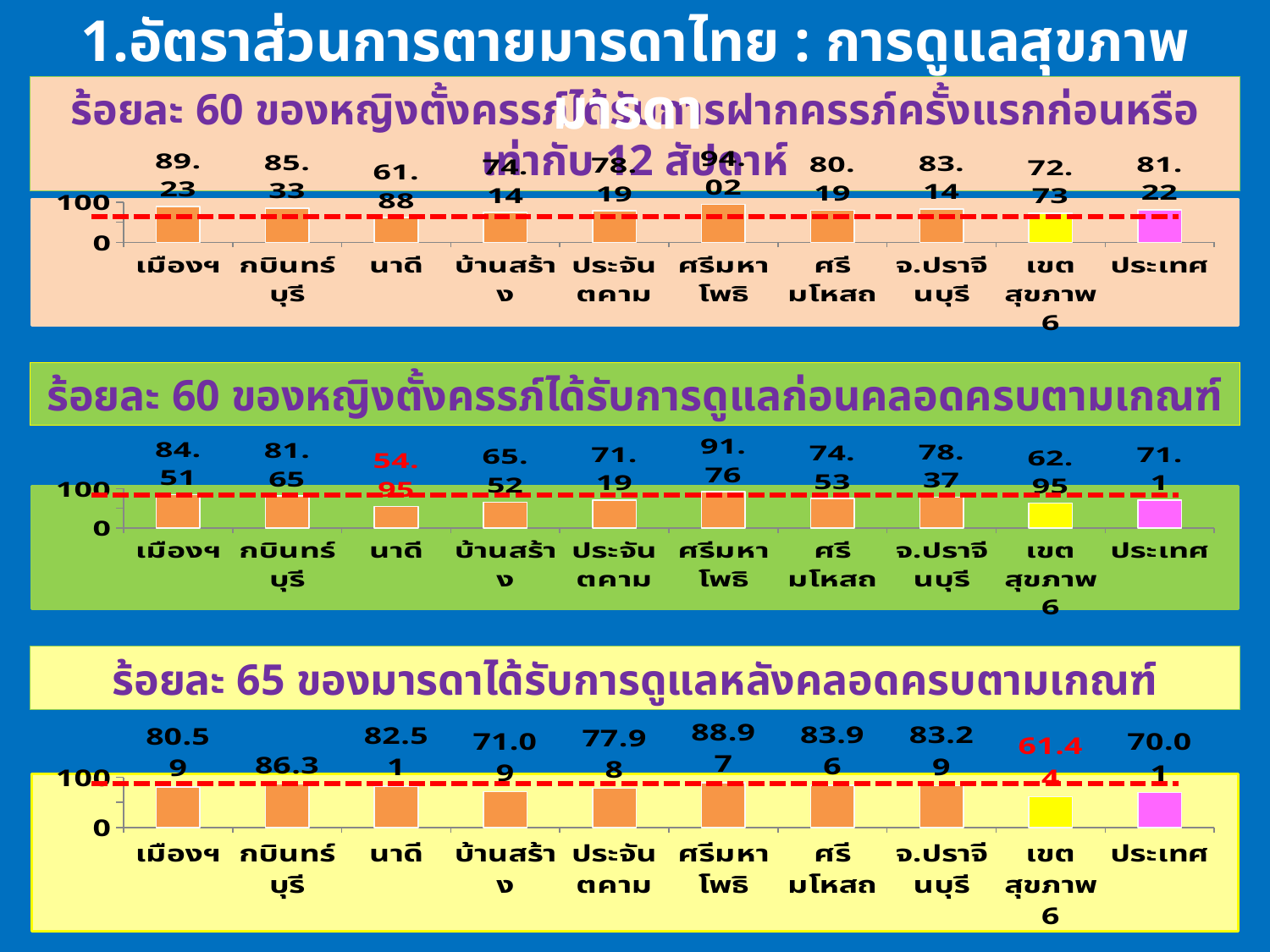
What type of chart is the middle chart? Bar chart In the middle chart, what is the value for นาดี? 54.95 In the middle chart, which is larger, the value for จ.ปราจีนบุรี or the value for เขตสุขภาพ 6? จ.ปราจีนบุรี In the top chart, what is the value for ศรีมหาโพธิ? 94.02 In the bottom chart, what is the difference between the values for กบินทร์บุรี and ประเทศ? 16.29 How many categories are shown in the bottom chart? 10 In the top chart, what colour is the bar for เขตสุขภาพ 6? Yellow In the top chart, what is the difference between the values for เมืองฯ and ประเทศ? 8.01 In the bottom chart, what is the value for เขตสุขภาพ 6? 61.44 In the bottom chart, which category has the highest value? ศรีมหาโพธิ In the top chart, which category has the lowest value? นาดี In the middle chart, which category has the highest value? ศรีมหาโพธิ